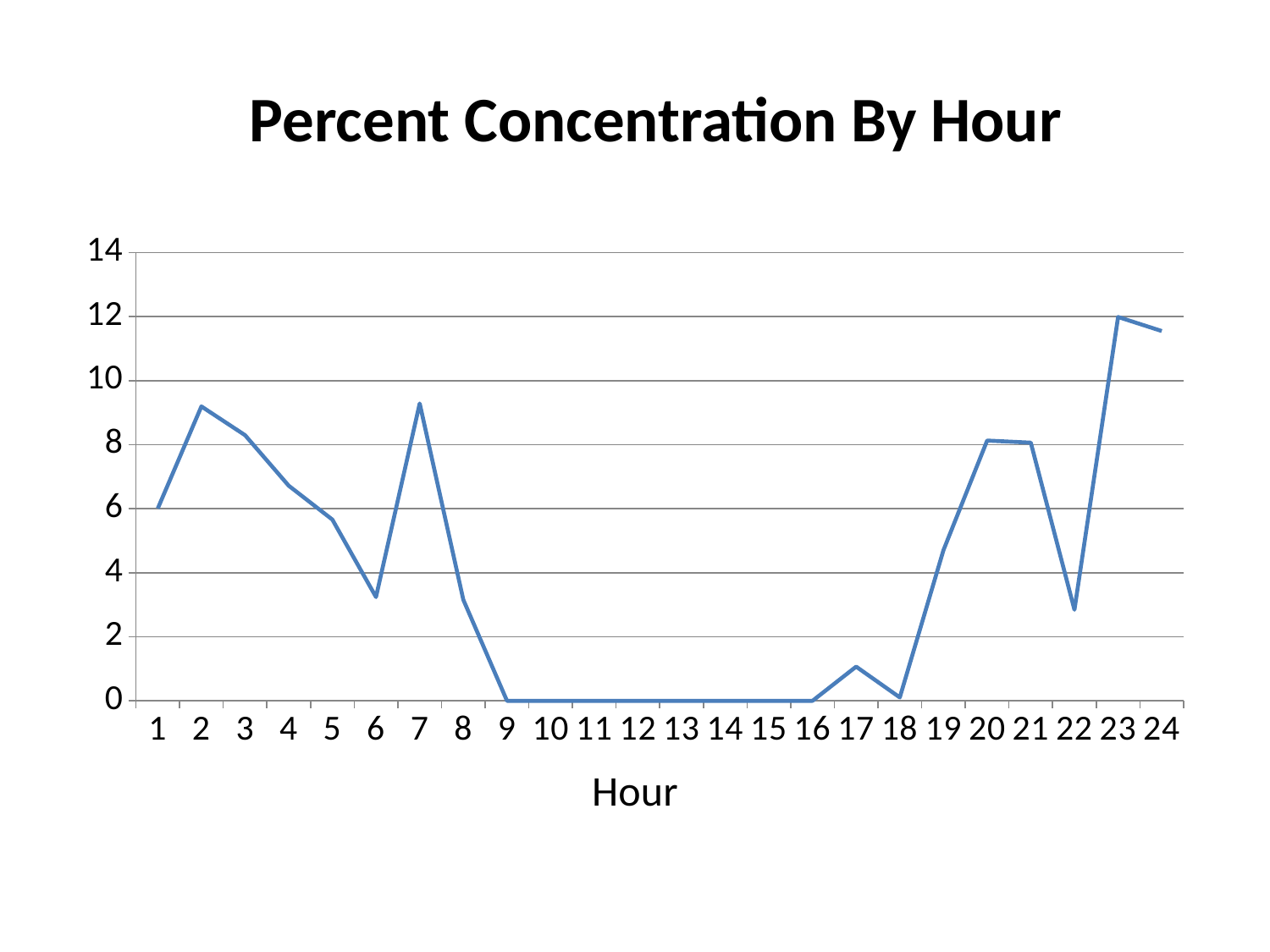
How many hours are plotted along the x axis? 24 Which has the higher value, hour 6 or hour 7? hour 7 What is the value at hour 14? 0 What is the value at hour 9? 0 At which hour does the line reach its highest value? 23 What is the label of the x axis? Hour Is the value for hour 6 greater or less than 4? less Does the line rise or fall from hour 2 to hour 6? fall Is the value for hour 24 greater or less than 10? greater Is the value for hour 2 greater or less than 8? greater What type of chart is shown on the slide? line chart What is the title of the chart? Percent Concentration By Hour